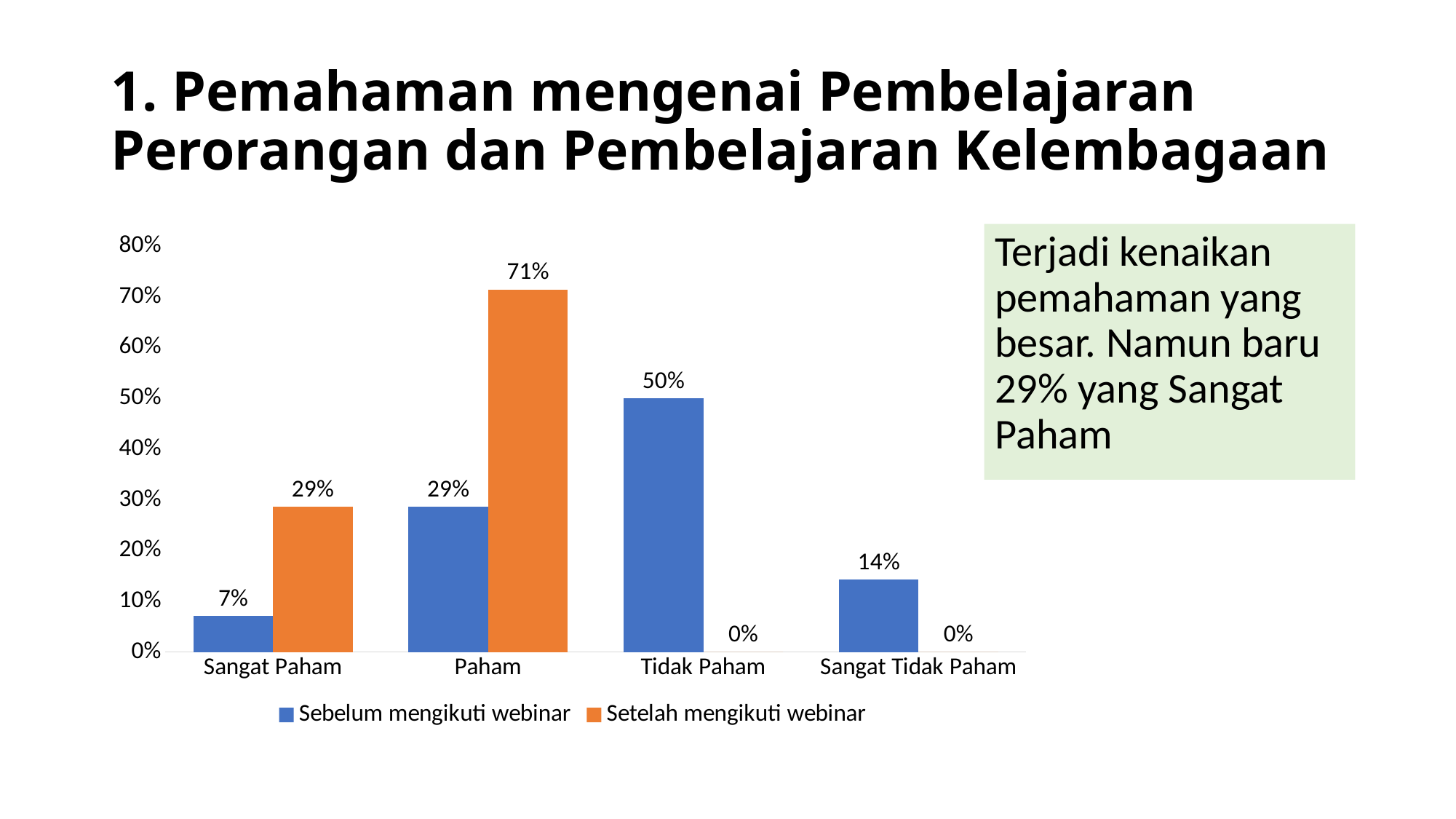
What is the value for Paham in the Setelah mengikuti webinar series? 71% Which colour represents the Setelah mengikuti webinar series? Orange What is the value for Tidak Paham in the Sebelum mengikuti webinar series? 50% What is the value for Sangat Tidak Paham in the Setelah mengikuti webinar series? 0% How many categories are shown on the x axis? 4 What is the value for Sangat Paham in the Sebelum mengikuti webinar series? 7% Which category has the lowest value in the Sebelum mengikuti webinar series? Sangat Paham How many series does the legend list? 2 What is the difference between the Setelah mengikuti webinar and Sebelum mengikuti webinar values for Paham? 42% Which category has the highest value in the Sebelum mengikuti webinar series? Tidak Paham Which is larger for Sangat Paham: the Sebelum mengikuti webinar value or the Setelah mengikuti webinar value? Setelah mengikuti webinar What kind of chart is shown on the slide? Bar chart